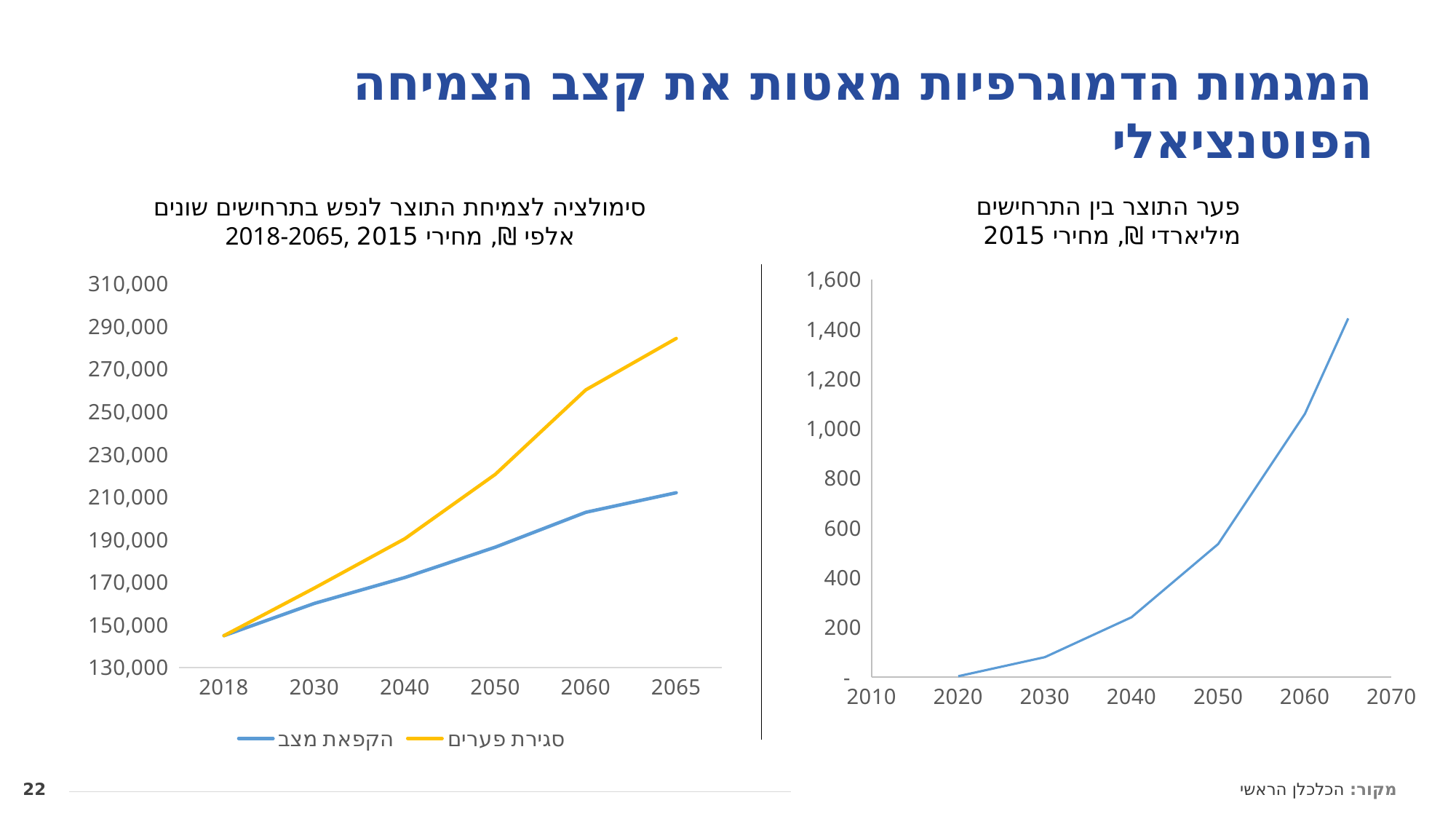
In the left chart, is the value of 'סגירת פערים' in 2050 greater or less than 210,000? greater In the left chart, which series is higher in 2065, 'הקפאת מצב' or 'סגירת פערים'? סגירת פערים In the left chart, is the value of 'סגירת פערים' in 2065 greater or less than 270,000? greater In the right chart, is the value in 2050 greater or less than 400? greater What kind of chart is the left chart, 'סימולציה לצמיחת התוצר לנפש בתרחישים שונים'? line chart In the left chart, which colour is the line for 'סגירת פערים'? yellow How many year labels are shown on the x axis of the left chart? 6 What kind of chart is the right chart, 'פער התוצר בין התרחישים'? line chart In the left chart, do the values of 'הקפאת מצב' rise or fall from 2018 to 2065? rise How many series does the legend of the left chart list? 2